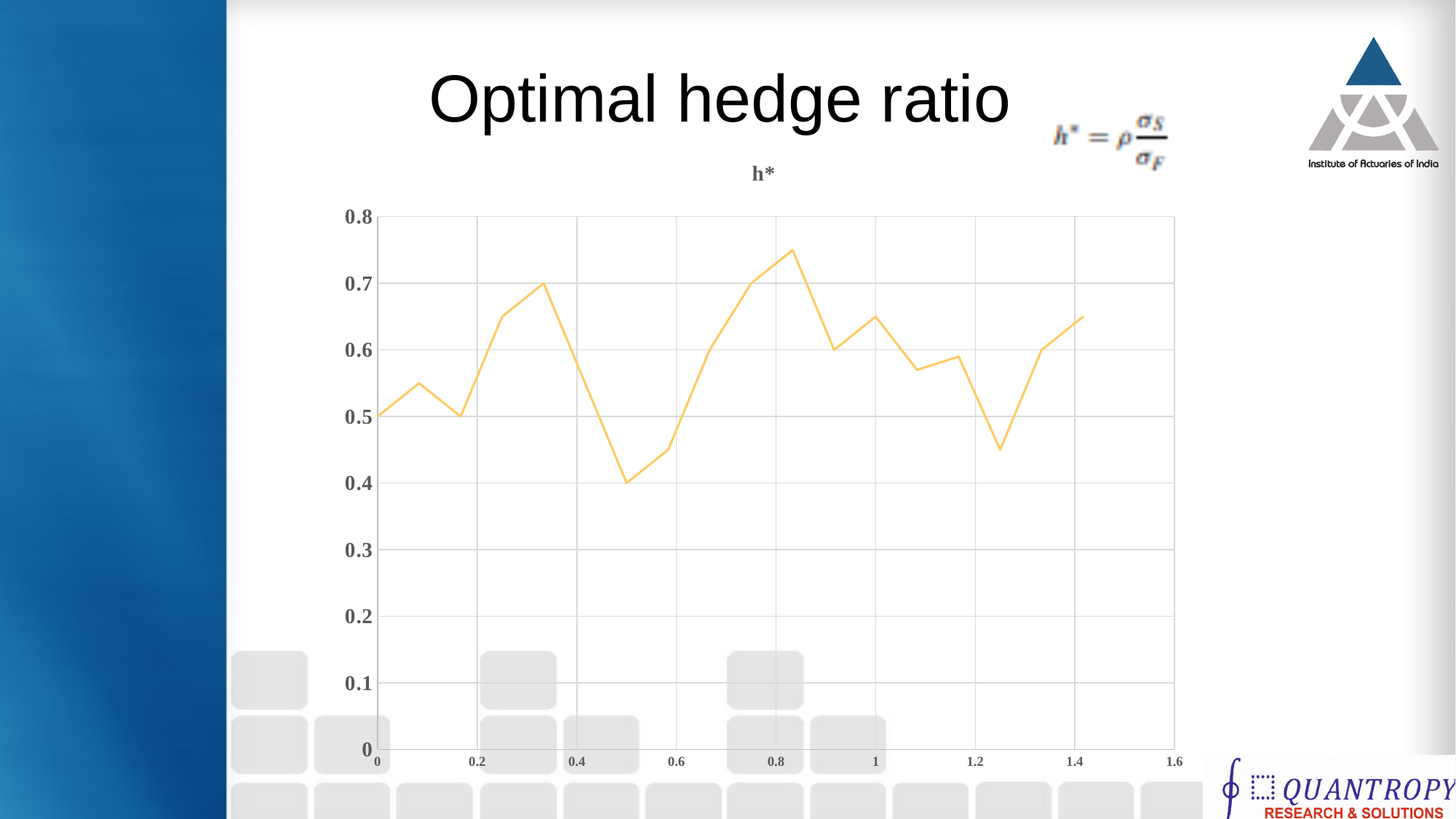
Is the highest value of the line greater or less than 0.7? greater What is the highest value shown on the y axis of the chart? 0.8 Which is larger: the value of the line at x = 0 or the lowest value of the line? the value at x = 0 How many lines are plotted on the chart? 1 What kind of chart is shown on the slide? line chart Is the value of the line at x = 1 greater or less than 0.6? greater What is the value of the line at x = 0? 0.5 Is the value of the line at x = 0 greater or less than 0.6? less Does the line rise or fall between x = 0.4 and x = 0.5? fall What is the lowest value the line reaches? 0.4 What is the title of the chart? h* Does the line rise or fall between x = 0.6 and x = 0.8? rise